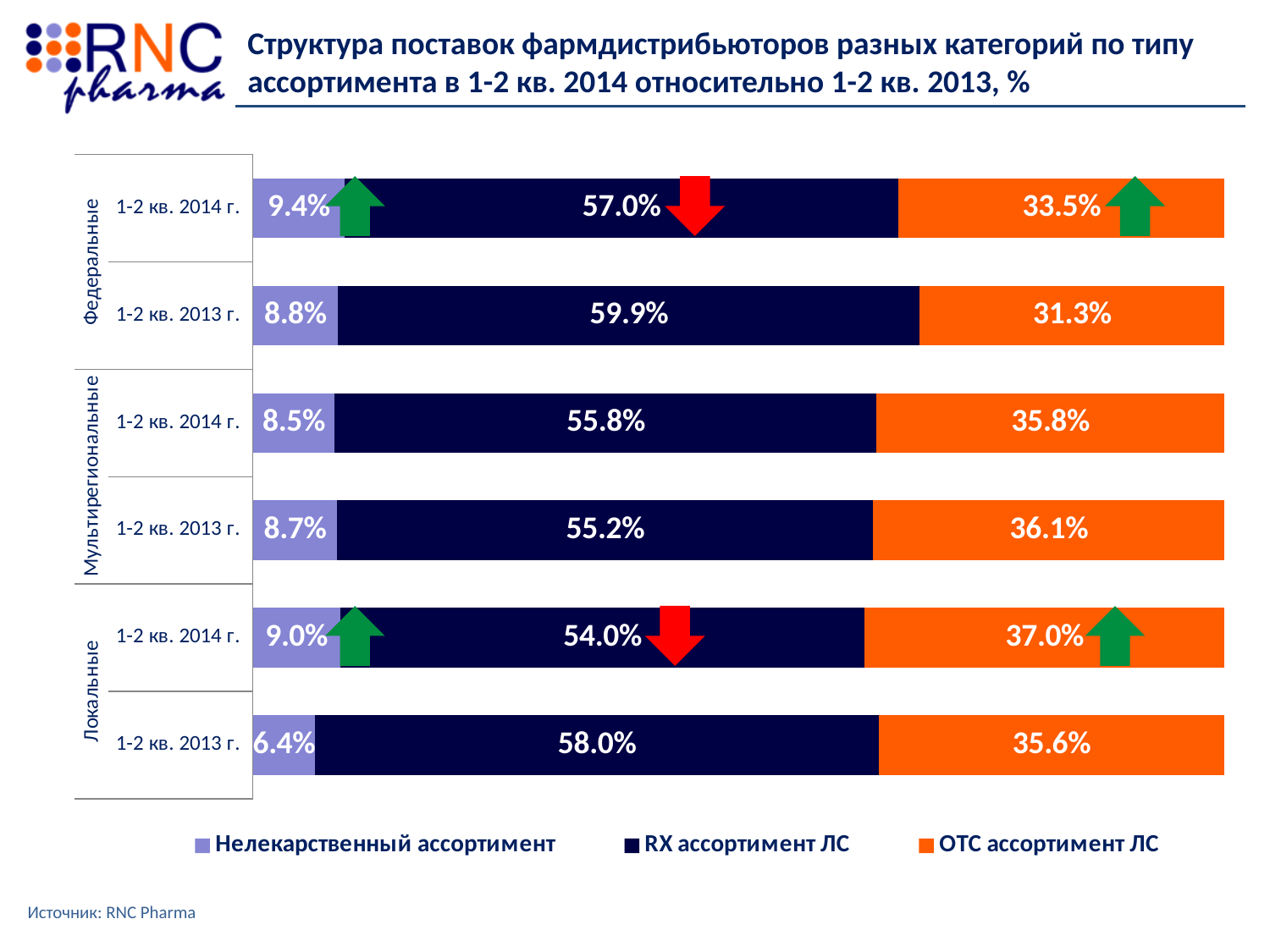
Which colour represents OTC ассортимент ЛС in the chart? Orange What is the RX ассортимент ЛС share for Федеральные distributors in 1-2 кв. 2014 г.? 57.0% What is the OTC ассортимент ЛС share for Локальные distributors in 1-2 кв. 2013 г.? 35.6% Which is larger: the RX ассортимент ЛС share for Локальные distributors in 1-2 кв. 2013 г. or in 1-2 кв. 2014 г.? 1-2 кв. 2013 г. Which bar has the lowest Нелекарственный ассортимент share? Локальные, 1-2 кв. 2013 г. How many bars are shown in the chart? 6 What is the Нелекарственный ассортимент share for Мультирегиональные distributors in 1-2 кв. 2014 г.? 8.5% What kind of chart is shown on the slide? Stacked bar chart What is the difference between the Нелекарственный ассортимент share for Локальные distributors in 1-2 кв. 2014 г. and 1-2 кв. 2013 г.? 2.6 percentage points By how many percentage points did the OTC ассортимент ЛС share for Федеральные distributors change from 1-2 кв. 2013 г. to 1-2 кв. 2014 г.? 2.2 percentage points How many series does the legend list? 3 Which bar has the highest RX ассортимент ЛС share? Федеральные, 1-2 кв. 2013 г.